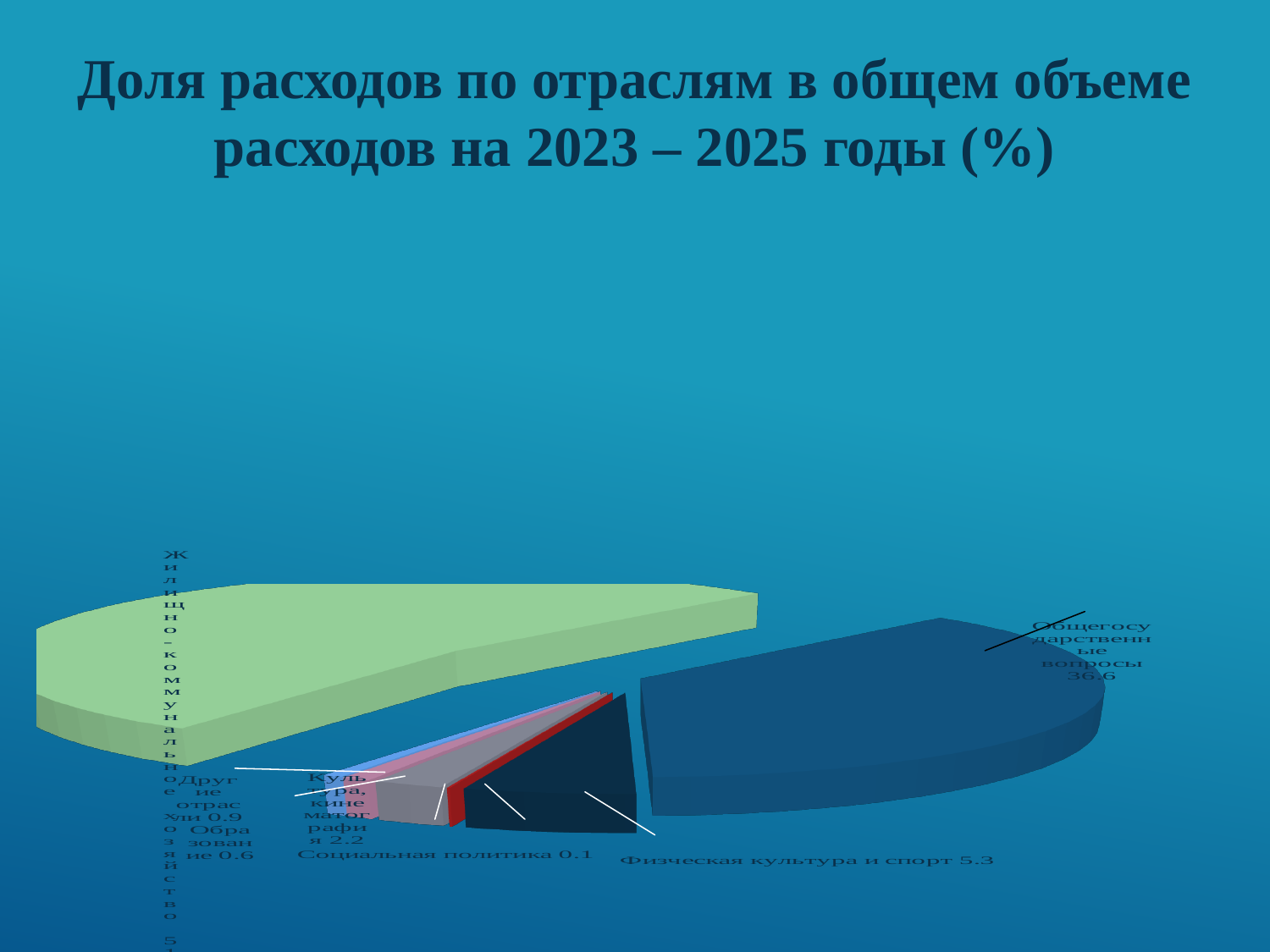
What kind of chart is shown on the slide? pie chart What is the share for Социальная политика? 0.1 What is the difference between the shares of Общегосударственные вопросы and Физическая культура и спорт? 31.3 Which is larger, Физическая культура и спорт or Культура, кинематография? Физическая культура и спорт What is the share for Другие отрасли? 0.9 What is the share for Физическая культура и спорт? 5.3 What is the share for Образование? 0.6 Which category has the smallest slice of the pie? Социальная политика What is the share for Культура, кинематография? 2.2 Which category has the largest slice of the pie? Жилищно-коммунальное хозяйство How many slices does the pie chart have? 7 What is the share for Общегосударственные вопросы? 36.6